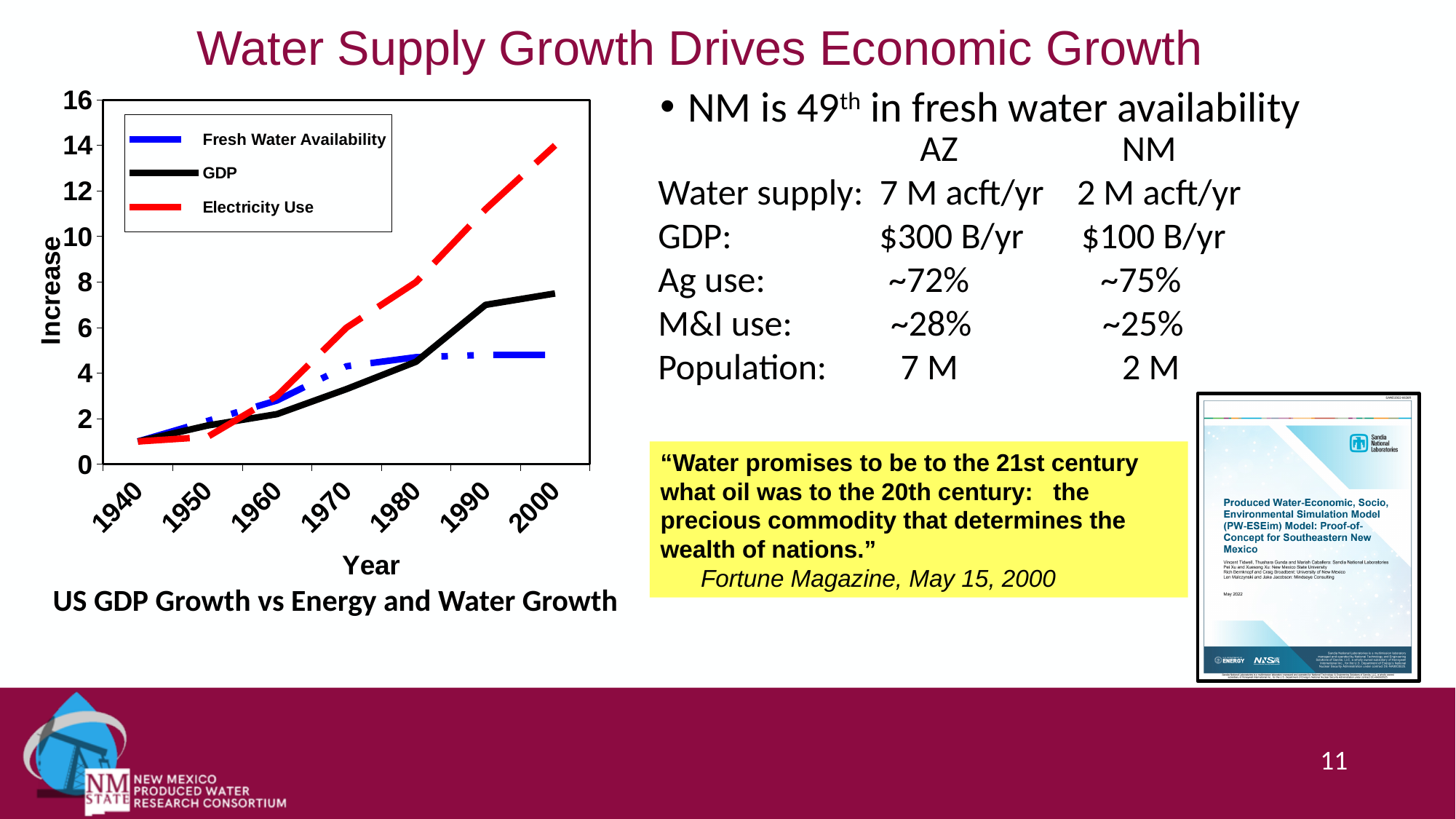
Which series has the highest value in 2000? Electricity Use Which series has the lowest value in 2000? Fresh Water Availability Is the value for Electricity Use in 2000 greater or less than 12? greater How many series does the chart legend list? 3 What kind of chart is shown on the slide? line chart Is the value for GDP in 2000 greater or less than 6? greater In 2000, which is larger: GDP or Fresh Water Availability? GDP What is the title of the chart? US GDP Growth vs Energy and Water Growth Is the value for Fresh Water Availability in 2000 greater or less than 6? less How many year labels are shown along the x axis of the chart? 7 Does the Electricity Use series rise or fall from 1940 to 2000? rise